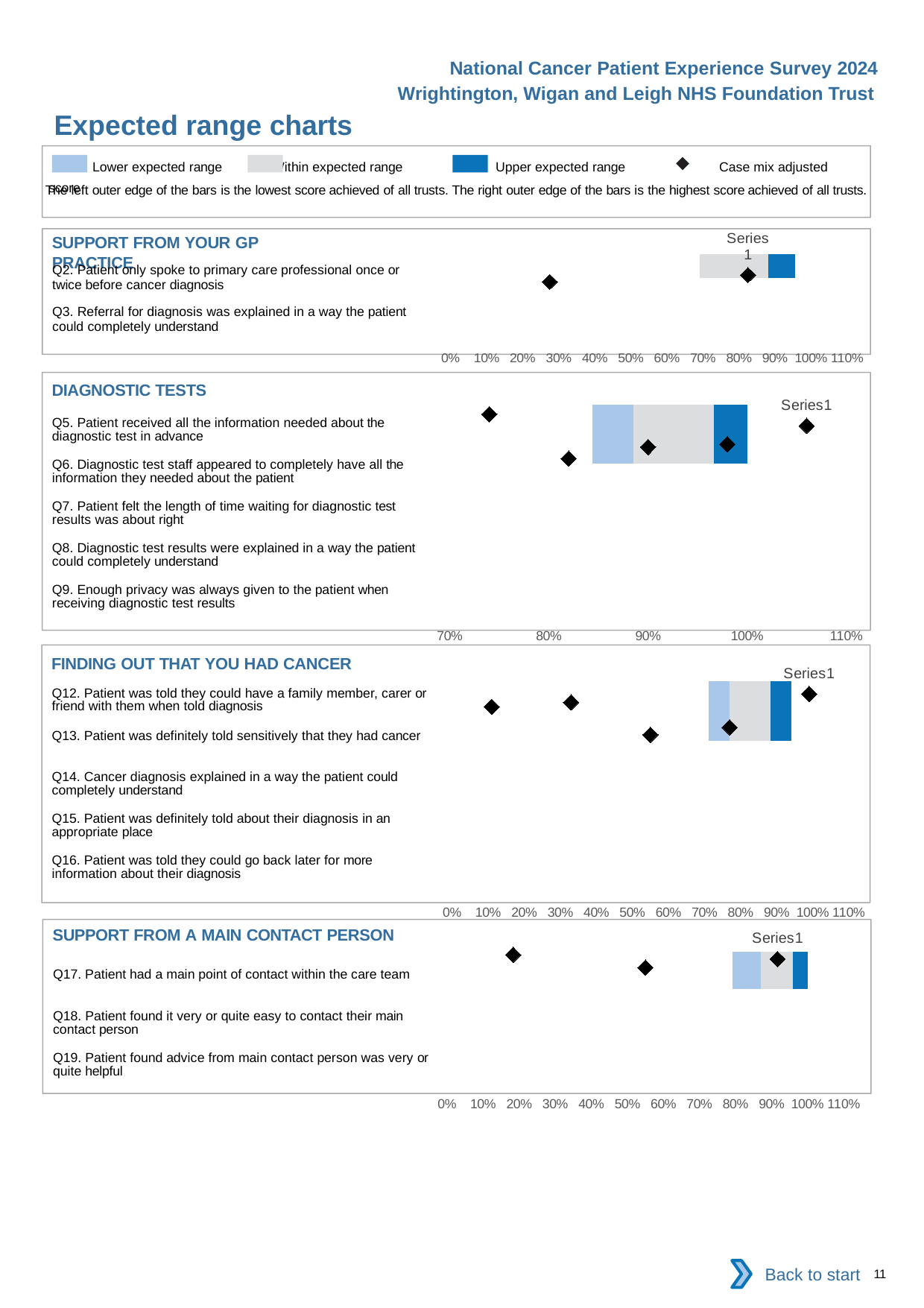
In the FINDING OUT THAT YOU HAD CANCER chart, is the right edge of the expected range bar greater or less than 60%? greater In the DIAGNOSTIC TESTS chart, what is the lowest value shown on the x axis? 70% What kind of chart is used in the DIAGNOSTIC TESTS section? bar chart In the DIAGNOSTIC TESTS chart, is the left edge of the expected range bar greater or less than 80%? greater How many entries does the legend at the top of the slide list? 4 According to the legend, which colour represents the upper expected range? dark blue In the SUPPORT FROM A MAIN CONTACT PERSON chart, is the left edge of the expected range bar greater or less than 70%? greater How many questions are listed in the SUPPORT FROM A MAIN CONTACT PERSON section? 3 How many questions are listed in the SUPPORT FROM YOUR GP PRACTICE section? 2 How many questions are listed in the DIAGNOSTIC TESTS section? 5